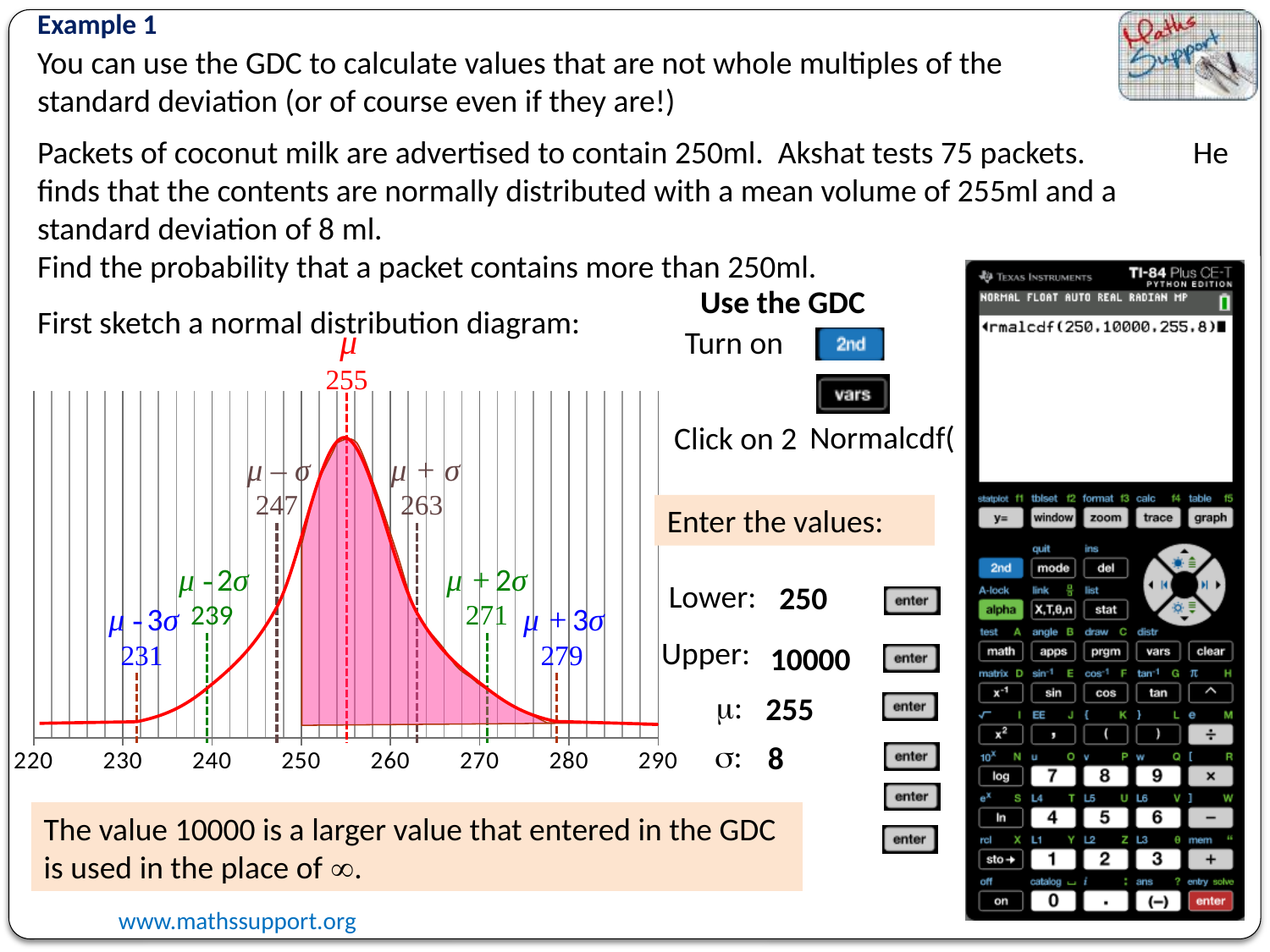
On the normal distribution diagram, what is the difference between the values labelled at μ + σ and μ − σ? 16 What is the highest value shown on the x axis of the normal distribution diagram? 290 On the normal distribution diagram, what value is labelled at μ − σ? 247 What kind of chart is the normal distribution diagram? Line chart (normal distribution curve) On the normal distribution diagram, what is the difference between the values labelled at μ + 3σ and μ − 3σ? 48 On the normal distribution diagram, at what x value does the pink shaded region begin? 250 On the normal distribution diagram, which is larger: the value labelled at μ − 2σ or the value labelled at μ + 2σ? μ + 2σ On the normal distribution diagram, what value is labelled at μ + 2σ? 271 What is the lowest value shown on the x axis of the normal distribution diagram? 220 On the normal distribution diagram, what value is labelled at μ − 3σ? 231 On the normal distribution diagram, what value is labelled at μ + σ? 263 On the normal distribution diagram, what value is labelled at the mean μ? 255